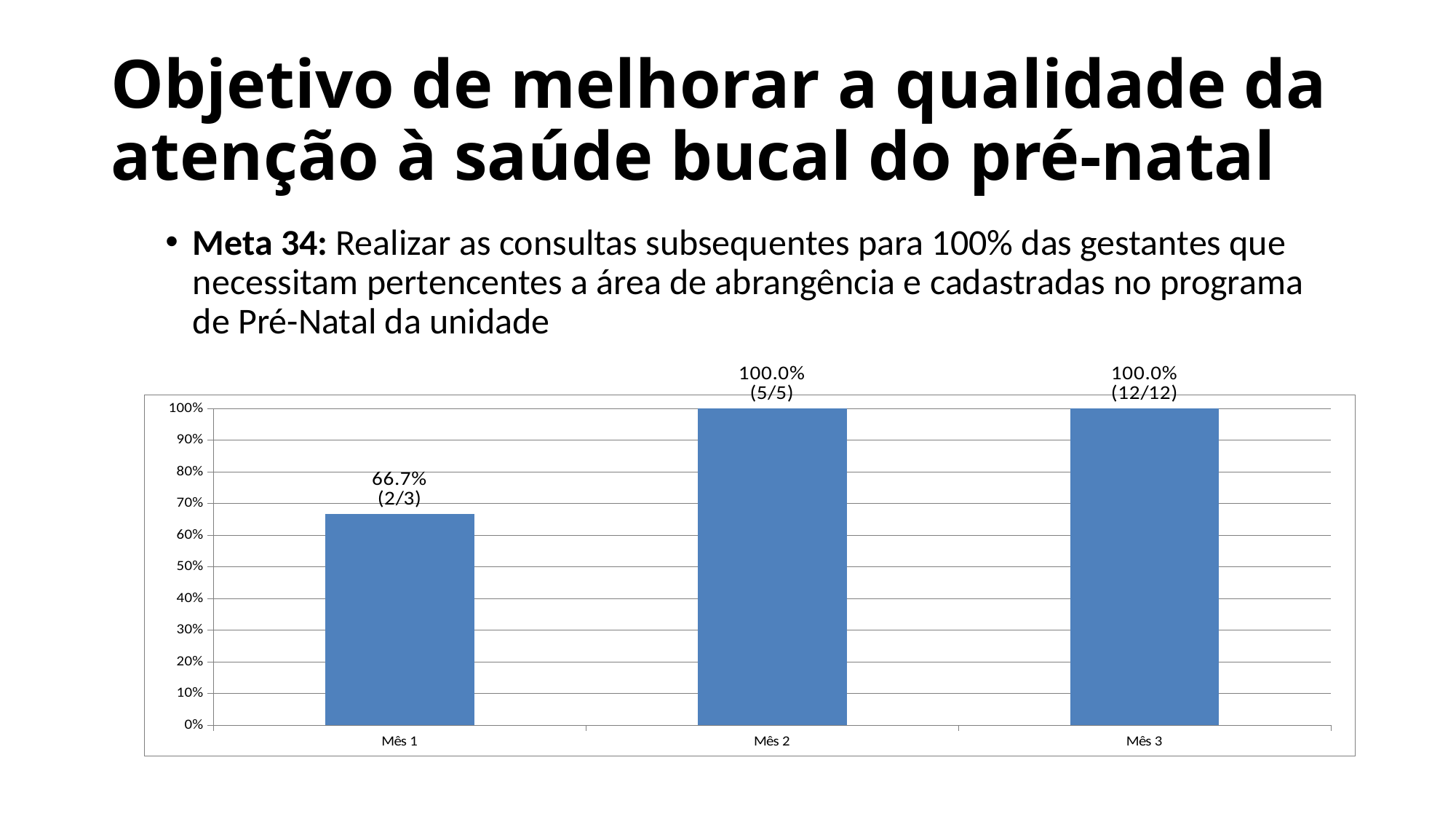
What fraction is shown in the data label for Mês 3? 12/12 What kind of chart is shown on the slide? bar chart What is the value for Mês 1? 66.7% What fraction is shown in the data label for Mês 1? 2/3 What is the value for Mês 3? 100.0% What is the difference between the values for Mês 2 and Mês 1? 33.3% Do the values rise or fall from Mês 1 to Mês 2? rise What is the value for Mês 2? 100.0% How many categories are shown on the x axis? 3 Is the value for Mês 1 greater or less than 50%? greater Which is larger, the value for Mês 1 or the value for Mês 3? Mês 3 Which month has the lowest value? Mês 1